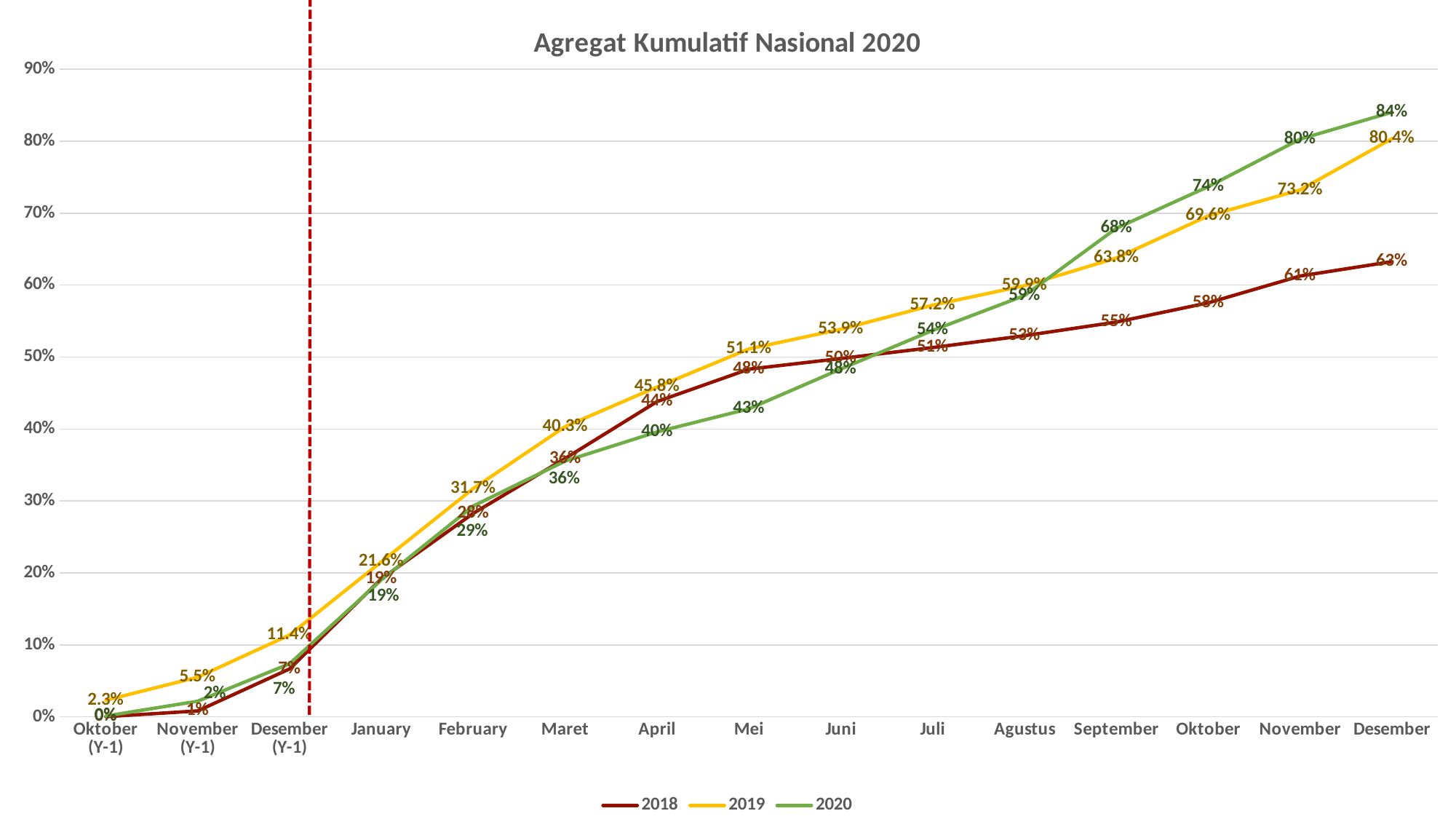
What is the difference between the 2020 and 2019 values in Desember? 3.6% In which category does the 2020 series reach its highest value? Desember What is the value for the 2019 series in Mei? 51.1% How many categories are shown along the x axis? 15 In Desember, which series has the larger value, 2019 or 2020? 2020 What kind of chart is shown on the slide? line chart Does the 2019 series rise or fall from Oktober (Y-1) to Desember? rise What is the title of the chart? Agregat Kumulatif Nasional 2020 What is the value for the 2020 series in Desember? 84% How many series does the legend list? 3 What is the value for the 2020 series in April? 40% What is the value for the 2019 series in Desember? 80.4%